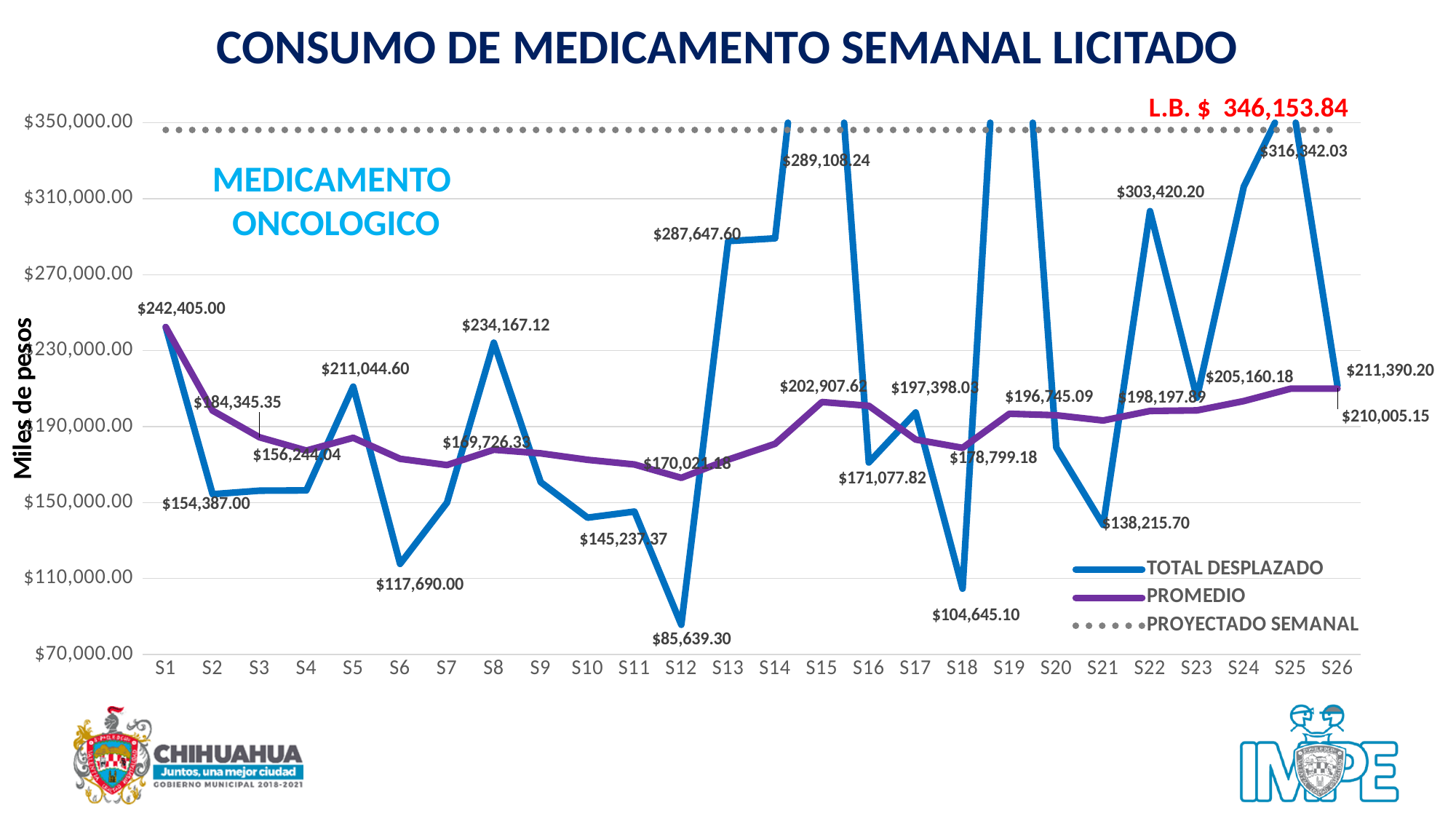
How many series does the legend list? 3 Which week has the larger TOTAL DESPLAZADO value, S6 or S18? S6 What is the difference between the TOTAL DESPLAZADO values for S24 and S22? $12,921.83 What is the label on the y axis? Miles de pesos What is the TOTAL DESPLAZADO value for S24? $316,342.03 In which week is TOTAL DESPLAZADO lowest? S12 What is the L.B. (PROYECTADO SEMANAL) value shown on the chart? $346,153.84 What is the TOTAL DESPLAZADO value for S12? $85,639.30 What is the TOTAL DESPLAZADO value for S1? $242,405.00 What type of chart is shown on the slide? line chart Is the TOTAL DESPLAZADO value for S4 greater or less than $190,000.00? less How many weeks (S1 to S26) are plotted on the x axis? 26